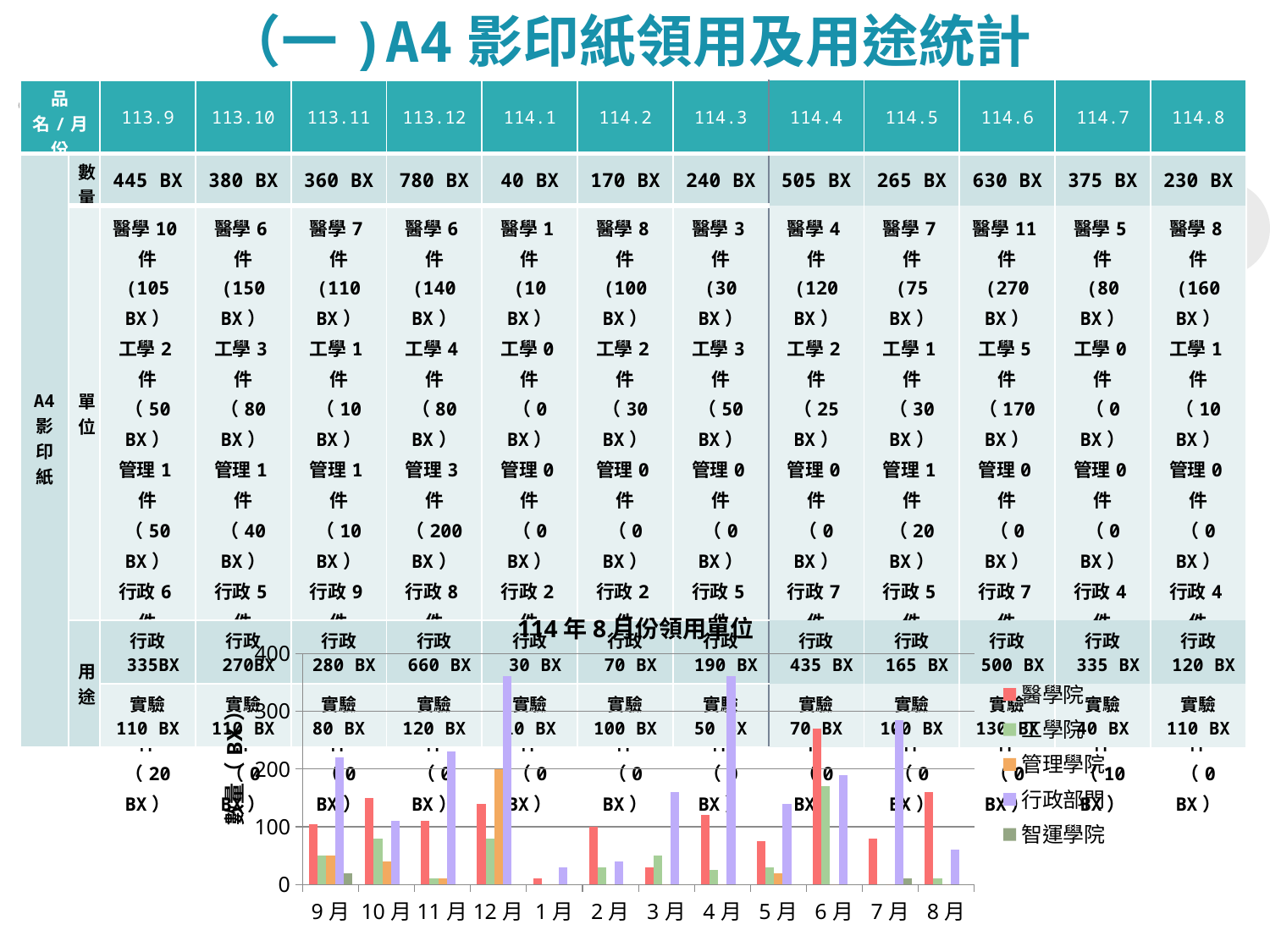
Which is larger: the 醫學院 value in 6月 or the 醫學院 value in 9月? 6月 Is the value for 醫學院 in 1月 greater or less than 100? less Which is larger: the 行政部門 value in 11月 or the 行政部門 value in 1月? 11月 What is the title of the chart on the slide? 114年8月份領用單位 Is the value for 工學院 in 6月 greater or less than 100? greater In which month is the 醫學院 bar the lowest? 1月 How many series does the chart legend list? 5 In which month is the 醫學院 bar the highest? 6月 Is the value for 行政部門 in 12月 greater or less than 300? greater What kind of chart is shown on the slide? bar chart How many months are shown along the x axis of the chart? 12 Which colour represents 行政部門 in the chart? purple